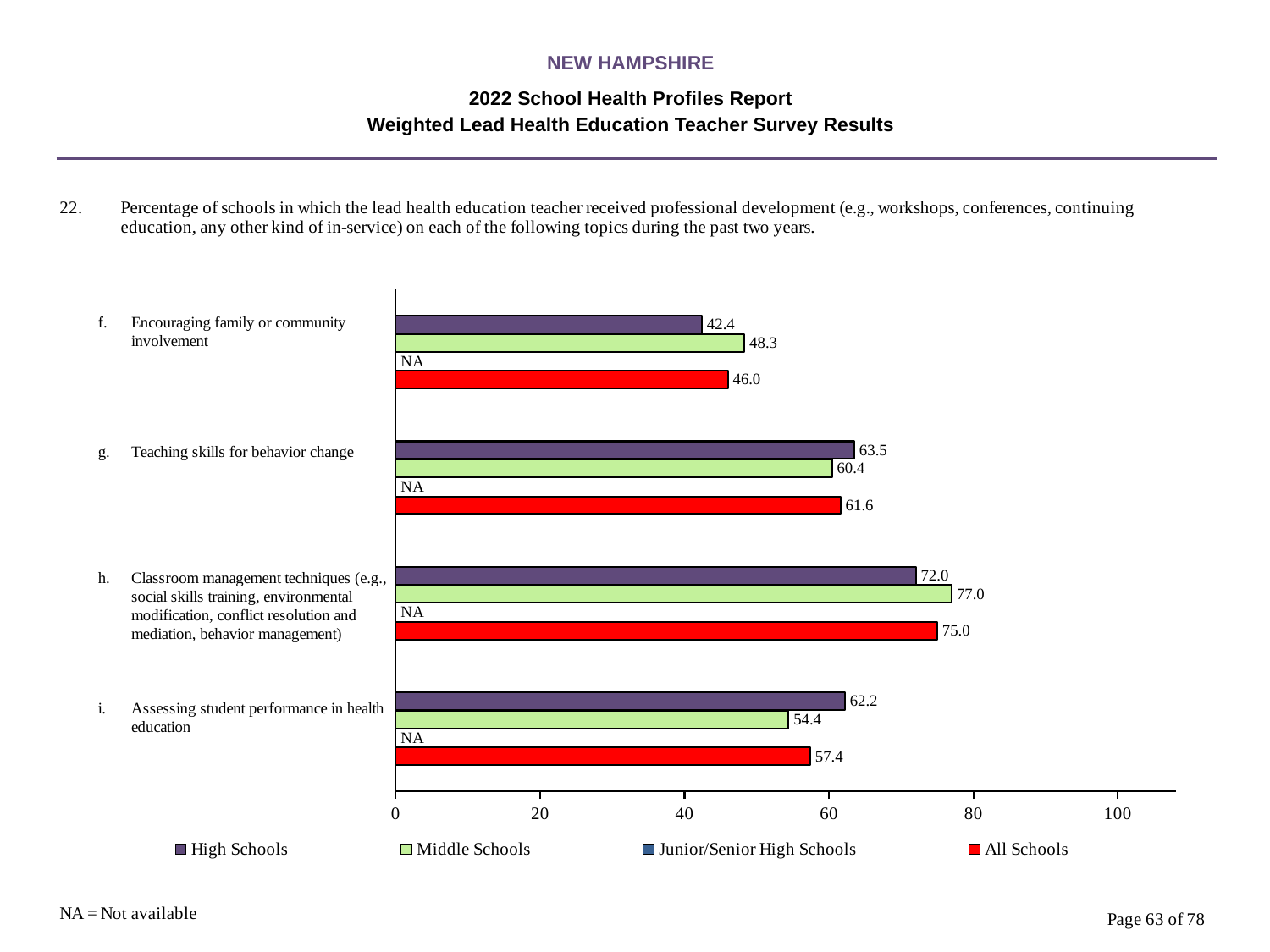
How many topics are shown on the chart? 4 For 'Teaching skills for behavior change', which is larger: the High Schools value or the Middle Schools value? High Schools What is the difference between the Middle Schools and High Schools values for 'Assessing student performance in health education'? 7.8 What is the value for All Schools for 'Encouraging family or community involvement'? 46.0 Which topic has the highest value for All Schools? Classroom management techniques What value is shown for Junior/Senior High Schools for each topic? NA How many series does the legend list? 4 What kind of chart is shown on the slide? Bar chart What is the value for Middle Schools for 'Classroom management techniques'? 77.0 Which topic has the lowest value for High Schools? Encouraging family or community involvement What is the value for Middle Schools for 'Assessing student performance in health education'? 54.4 What is the value for High Schools for 'Teaching skills for behavior change'? 63.5